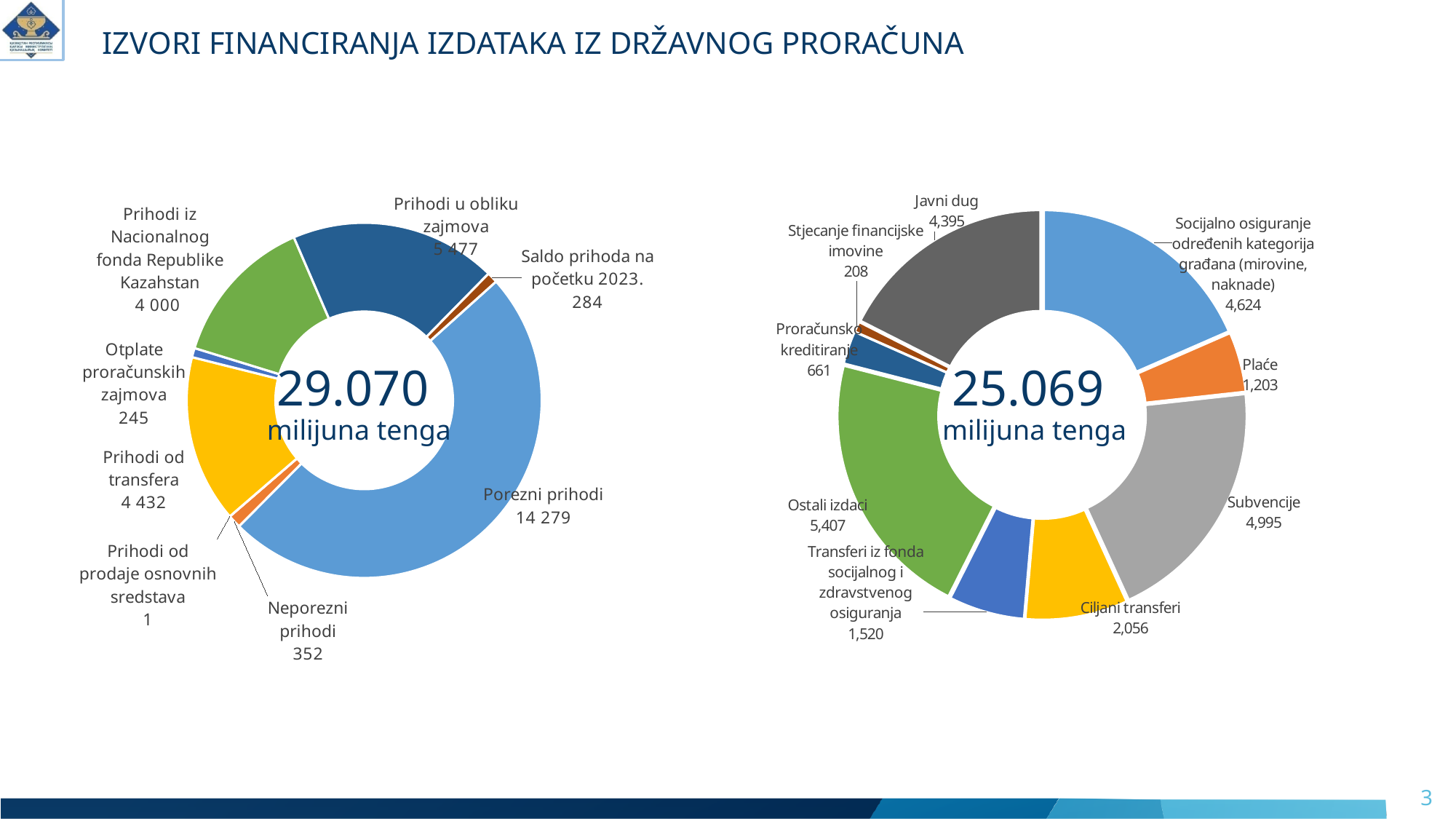
In the right donut chart, which category has the lowest value? Stjecanje financijske imovine In the right donut chart (25.069 milijuna tenga), what is the value for Subvencije? 4,995 In the right donut chart, which category has the highest value? Ostali izdaci In the left donut chart, what is the difference between Prihodi u obliku zajmova and Prihodi iz Nacionalnog fonda Republike Kazahstan? 1 477 In the left donut chart, which category has the highest value? Porezni prihodi In the right donut chart, which is larger: Ciljani transferi or Plaće? Ciljani transferi In the left donut chart, how many categories are shown? 8 In the right donut chart, what is the value for Javni dug? 4,395 In the left donut chart, what is the value for Prihodi od transfera? 4 432 In the left donut chart (29.070 milijuna tenga), what is the value for Porezni prihodi? 14 279 In the left donut chart, which category has the lowest value? Prihodi od prodaje osnovnih sredstava What type of chart is used on this slide? Donut (pie) chart